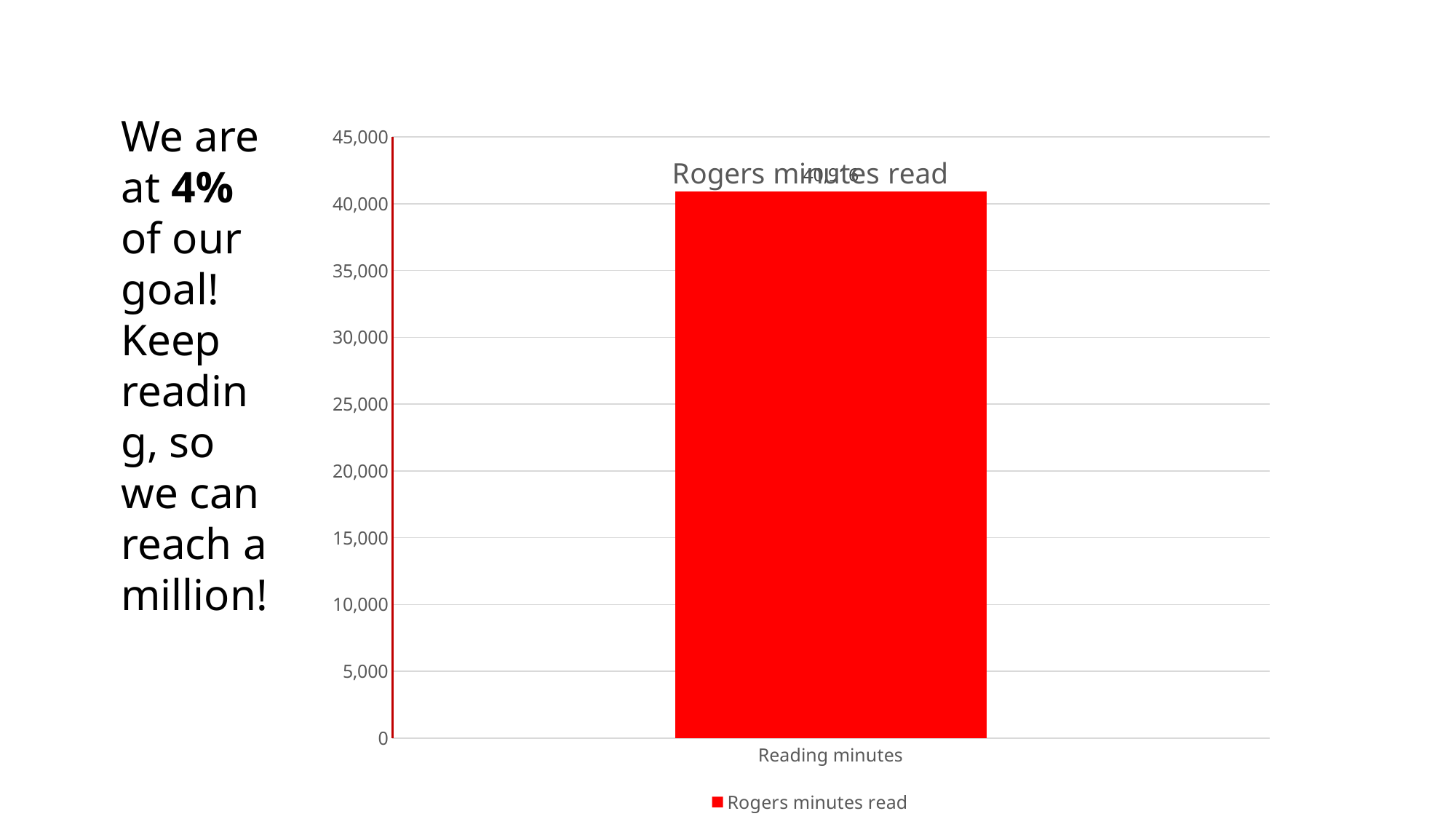
What is the title of the chart? Rogers minutes read How many bars are plotted in the chart? 1 What is the highest value shown on the chart's vertical axis? 45,000 What is the category label shown on the x axis of the chart? Reading minutes Is the value for Reading minutes greater or less than 40,000? greater Is the value for Reading minutes greater or less than 35,000? greater Is the value for Reading minutes greater or less than 45,000? less How many series does the chart legend list? 1 What kind of chart is shown on the slide? bar chart